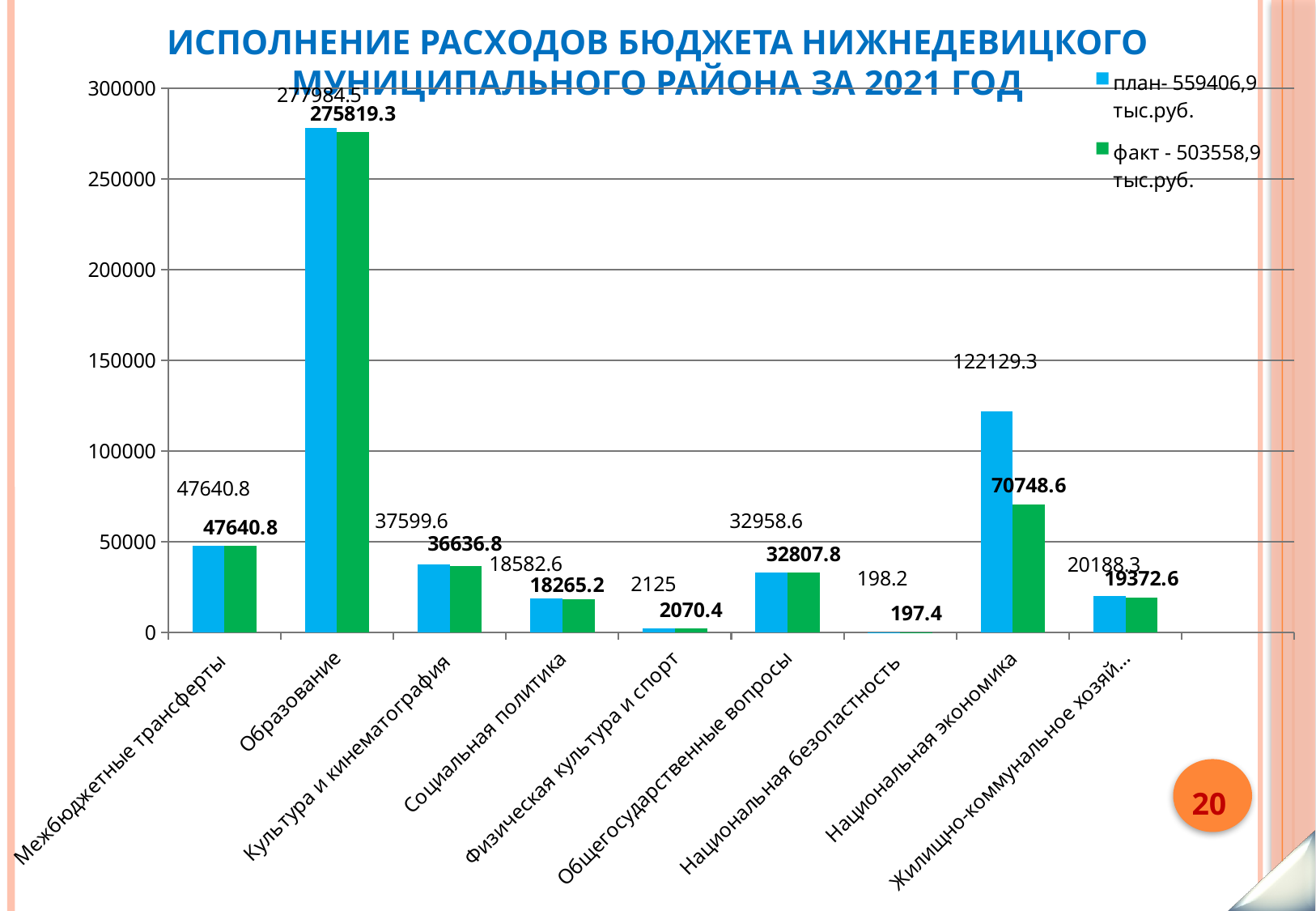
What is the план value for Физическая культура и спорт? 2125 Is the план value for Национальная экономика greater or less than 100000? greater Which is larger: the факт value for Культура и кинематография or the факт value for Общегосударственные вопросы? Культура и кинематография How many series does the legend list? 2 Which category has the lowest план value? Национальная безопастность What kind of chart is shown on the slide? bar chart What is the факт value for Культура и кинематография? 36636.8 What is the план value for Национальная экономика? 122129.3 Which category has the highest факт value? Образование What is the факт value for Национальная экономика? 70748.6 How many categories are shown on the x axis? 9 What is the difference between the план and факт values for Национальная экономика? 51380.7